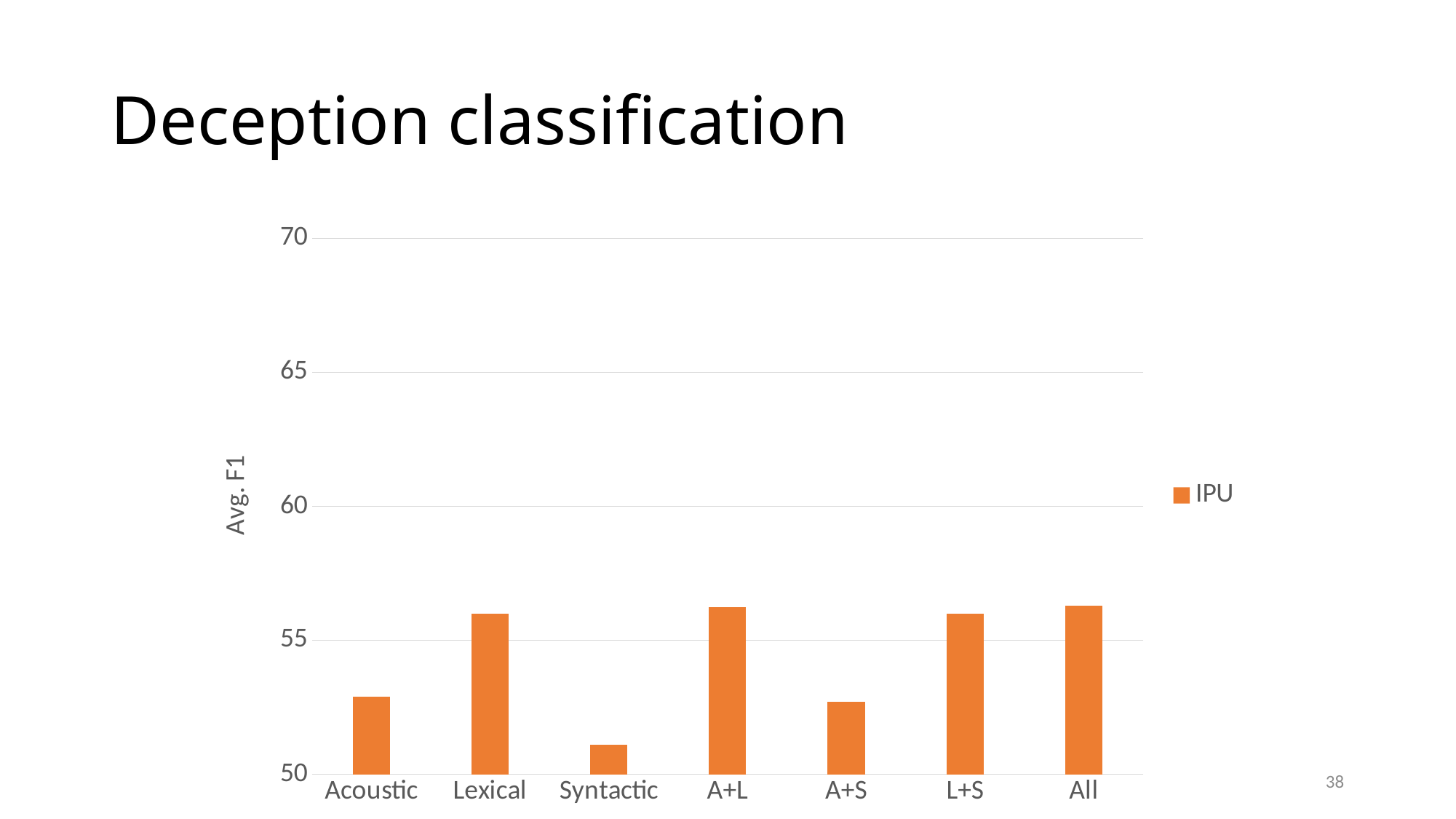
How many series does the chart's legend list? 1 Is the value for A+S greater or less than 55? less Is the value for Acoustic greater or less than 55? less What series name is shown in the chart's legend? IPU Which has the larger Avg. F1, Acoustic or A+L? A+L Which category has the lowest Avg. F1 in the chart? Syntactic Is the value for Lexical greater or less than 55? greater Which has the larger Avg. F1, Lexical or Syntactic? Lexical How many categories are shown on the x axis of the chart? 7 What kind of chart is shown on the slide? bar chart